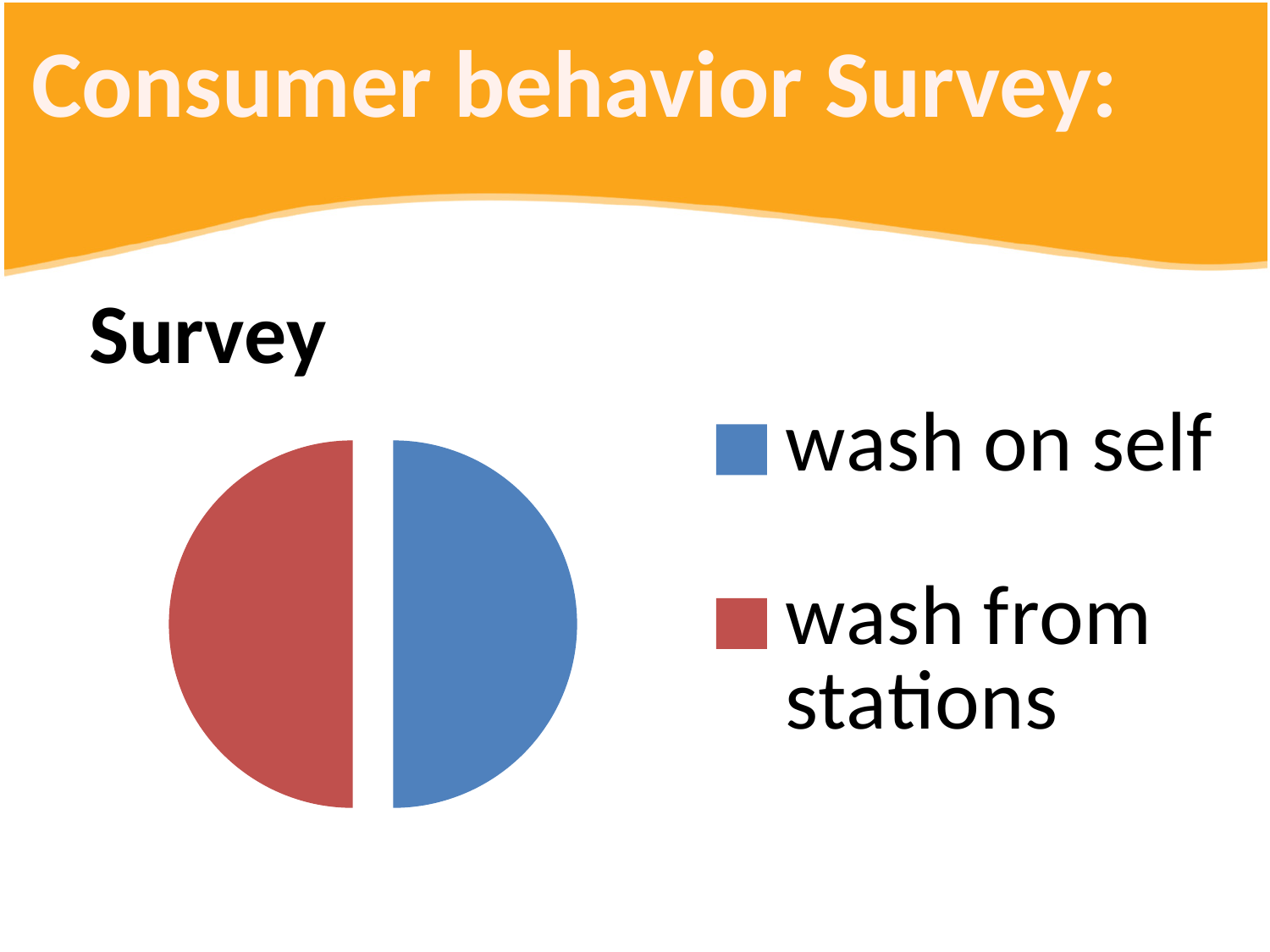
Which colour represents "wash on self" in the pie chart? blue Which category in the pie chart is shown in red? wash from stations What kind of chart is shown on the slide? pie chart What is the title of the pie chart? Survey How many slices does the pie chart have? 2 How many entries does the legend of the pie chart list? 2